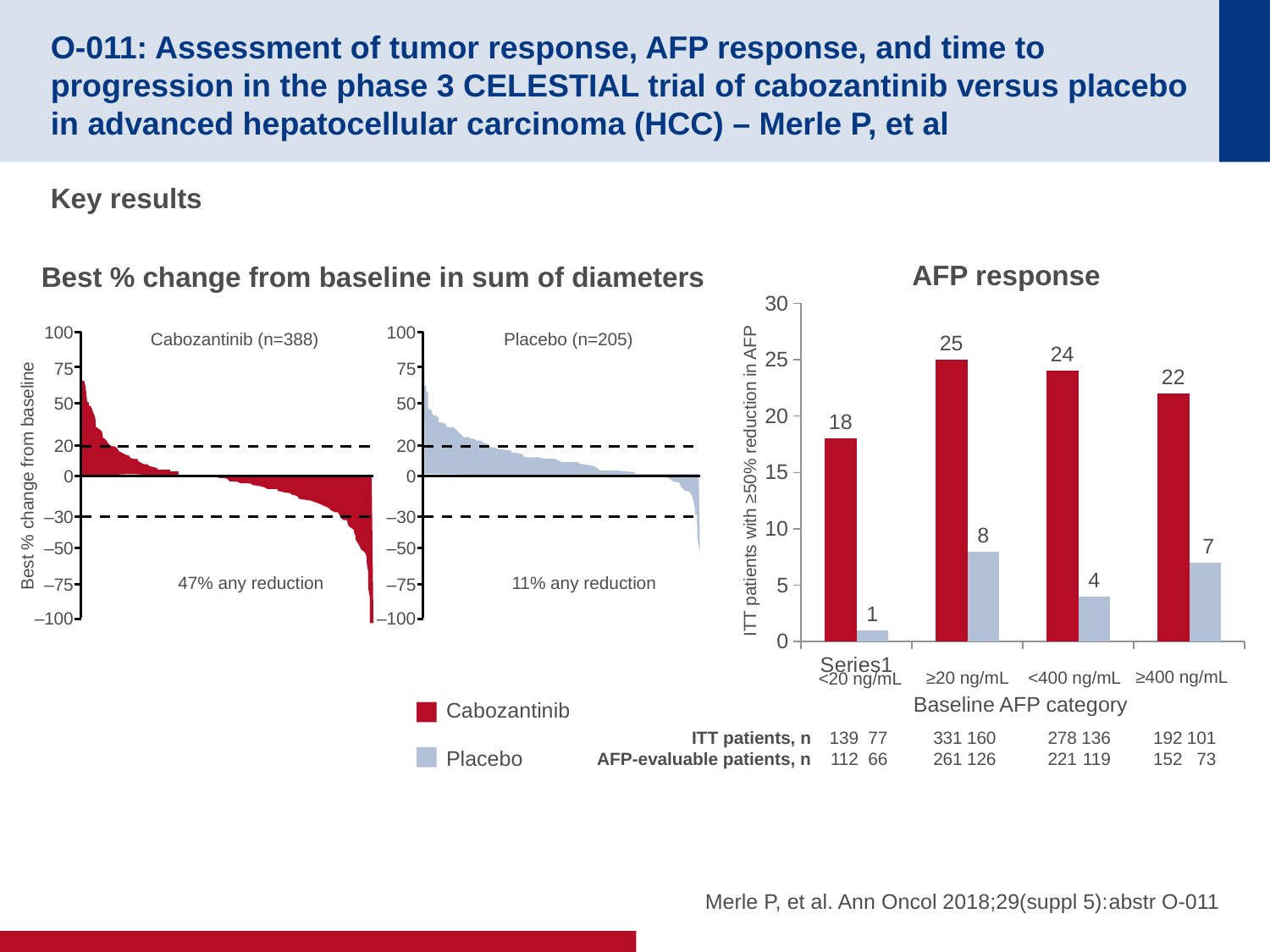
What kind of chart is the AFP response chart? Bar chart In the AFP response chart, what is the difference between the Cabozantinib and Placebo values in the <400 ng/mL category? 20 In the Best % change from baseline in sum of diameters charts, what percentage of Placebo patients had any reduction? 11% any reduction In the AFP response chart, how many baseline AFP categories are shown on the x axis? 4 In the AFP response chart, what is the value for Placebo in the ≥20 ng/mL category? 8 In the AFP response chart, which is larger: the Placebo value for ≥20 ng/mL or the Placebo value for ≥400 ng/mL? ≥20 ng/mL How many series does the legend list for the AFP response chart? 2 In the AFP response chart, what is the value for Cabozantinib in the <20 ng/mL category? 18 In the AFP response chart, which baseline AFP category has the lowest Placebo value? <20 ng/mL In the AFP response chart, what is the value for Cabozantinib in the ≥400 ng/mL category? 22 In the AFP response chart, which baseline AFP category has the highest Cabozantinib value? ≥20 ng/mL In the AFP response chart, what is the label of the y axis? ITT patients with ≥50% reduction in AFP